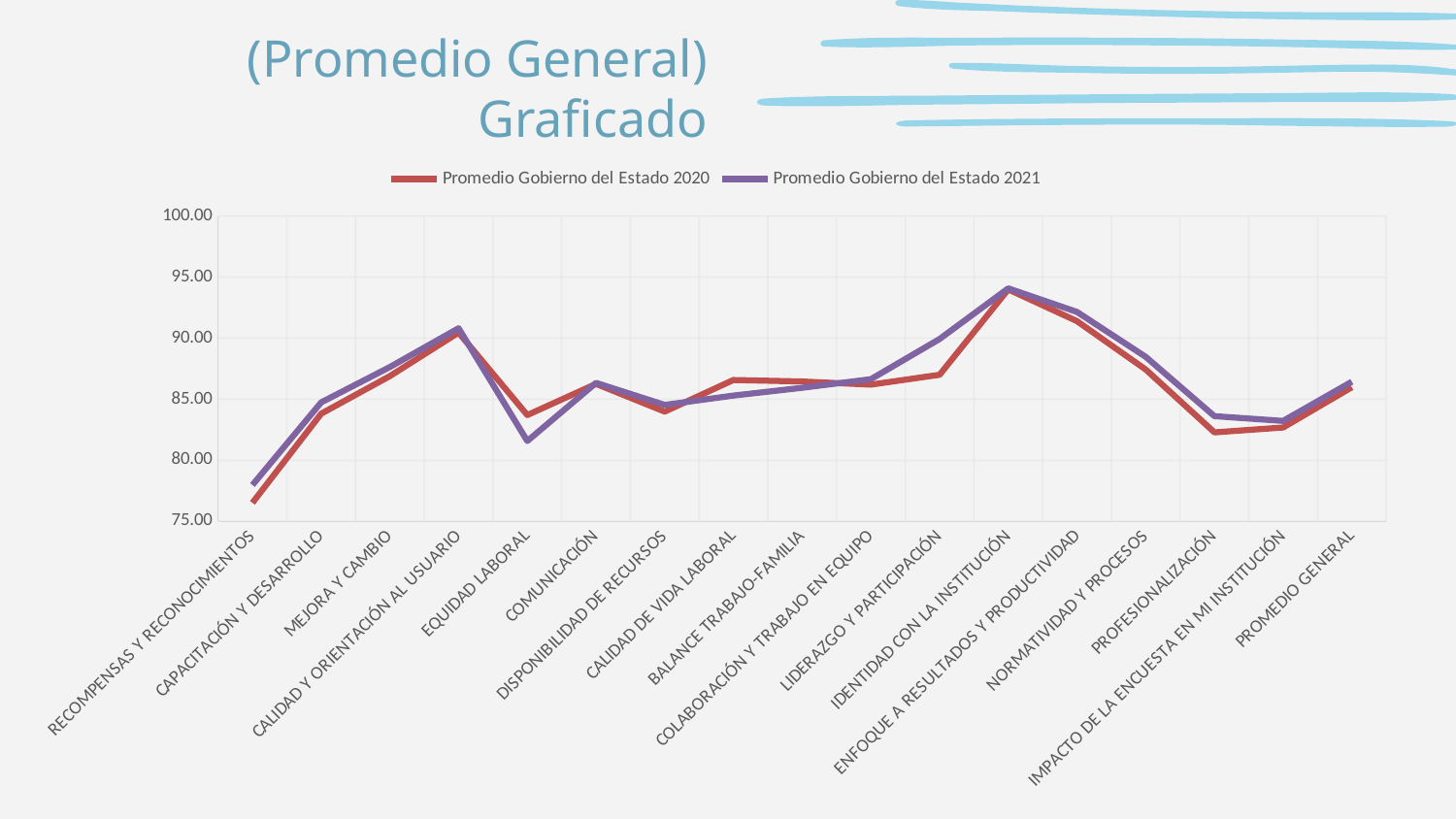
How many series does the legend list? 2 What kind of chart is shown on the slide? line chart How many categories are plotted along the x axis? 17 Is the value for EQUIDAD LABORAL in the Promedio Gobierno del Estado 2021 series greater or less than 85.00? less For LIDERAZGO Y PARTICIPACIÓN, which series has the larger value: Promedio Gobierno del Estado 2020 or Promedio Gobierno del Estado 2021? Promedio Gobierno del Estado 2021 Which series is drawn in purple? Promedio Gobierno del Estado 2021 Which category has the highest value for Promedio Gobierno del Estado 2020? IDENTIDAD CON LA INSTITUCIÓN Is the value for RECOMPENSAS Y RECONOCIMIENTOS in the Promedio Gobierno del Estado 2020 series greater or less than 80.00? less For EQUIDAD LABORAL, which series has the larger value: Promedio Gobierno del Estado 2020 or Promedio Gobierno del Estado 2021? Promedio Gobierno del Estado 2020 Which category has the lowest value for Promedio Gobierno del Estado 2021? RECOMPENSAS Y RECONOCIMIENTOS Is the value for CALIDAD Y ORIENTACIÓN AL USUARIO in the Promedio Gobierno del Estado 2020 series greater or less than 85.00? greater